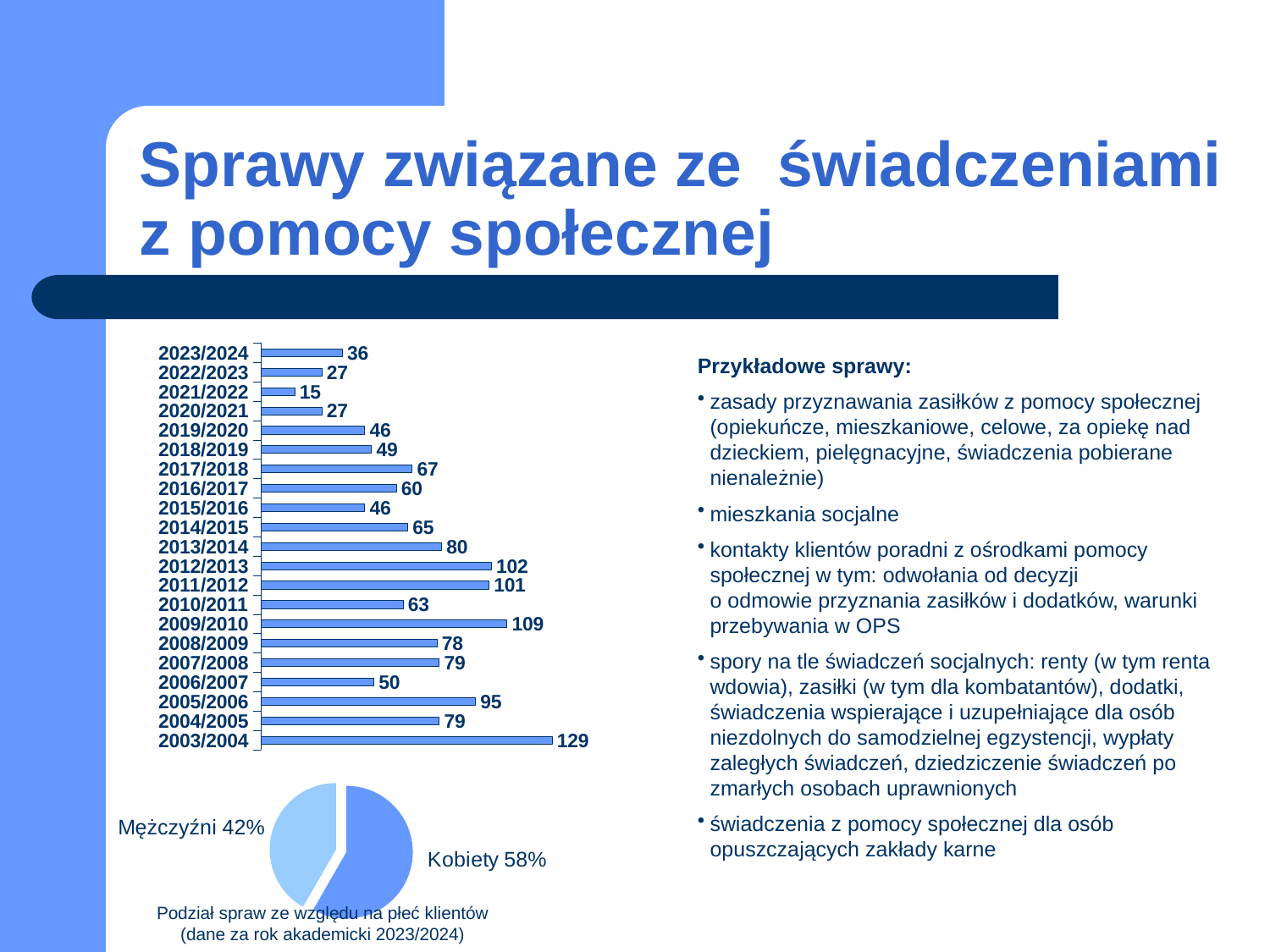
In the bar chart, what is the value for 2021/2022? 15 In the pie chart, what share is labelled Mężczyźni? 42% How many slices does the pie chart have? 2 How many academic years are shown in the bar chart? 21 In the bar chart, what is the difference between the values for 2012/2013 and 2010/2011? 39 In the bar chart, which academic year has the highest value? 2003/2004 In the bar chart, what is the value for 2003/2004? 129 In the pie chart, what share is labelled Kobiety? 58% In the bar chart, what is the value for 2009/2010? 109 In the bar chart, which academic year has the lowest value? 2021/2022 In the bar chart, which is larger: the value for 2005/2006 or the value for 2013/2014? 2005/2006 What type of chart shows the values by academic year? bar chart